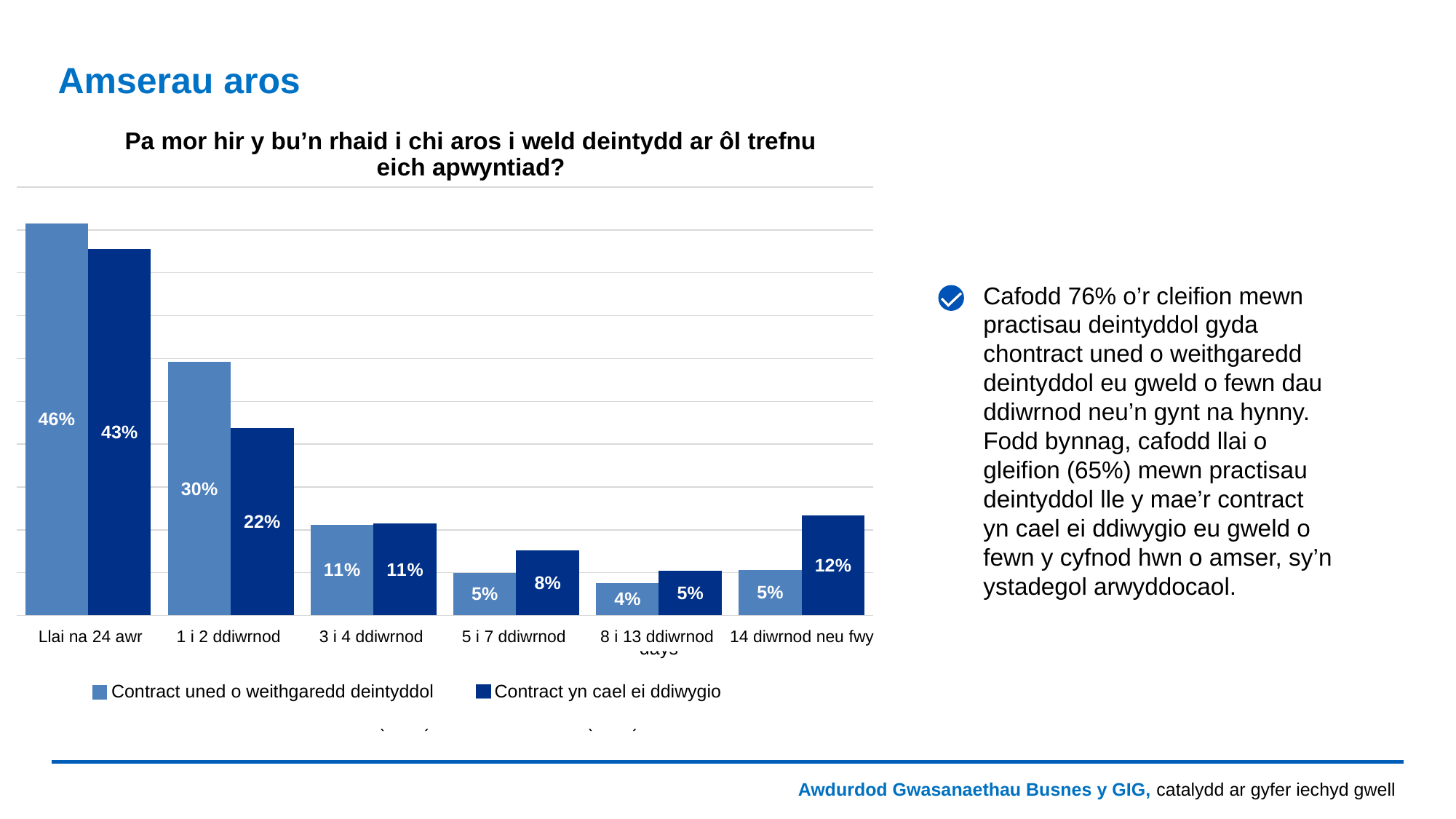
What is the value for '14 diwrnod neu fwy' in the 'Contract yn cael ei ddiwygio' series? 12% Which category has the highest value in the 'Contract uned o weithgaredd deintyddol' series? Llai na 24 awr What is the value for 'Llai na 24 awr' in the 'Contract uned o weithgaredd deintyddol' series? 46% What is the title of the chart? Pa mor hir y bu'n rhaid i chi aros i weld deintydd ar ôl trefnu eich apwyntiad? How many series does the legend list? 2 How many categories are shown on the x axis? 6 Which category has the lowest value in the 'Contract uned o weithgaredd deintyddol' series? 8 i 13 ddiwrnod What is the difference between the two series for '1 i 2 ddiwrnod'? 8% For '14 diwrnod neu fwy', which series has the larger value? Contract yn cael ei ddiwygio What kind of chart is shown on the slide? Bar chart What is the value for '1 i 2 ddiwrnod' in the 'Contract yn cael ei ddiwygio' series? 22% Do the values in the 'Contract uned o weithgaredd deintyddol' series generally rise or fall from 'Llai na 24 awr' to '8 i 13 ddiwrnod'? Fall